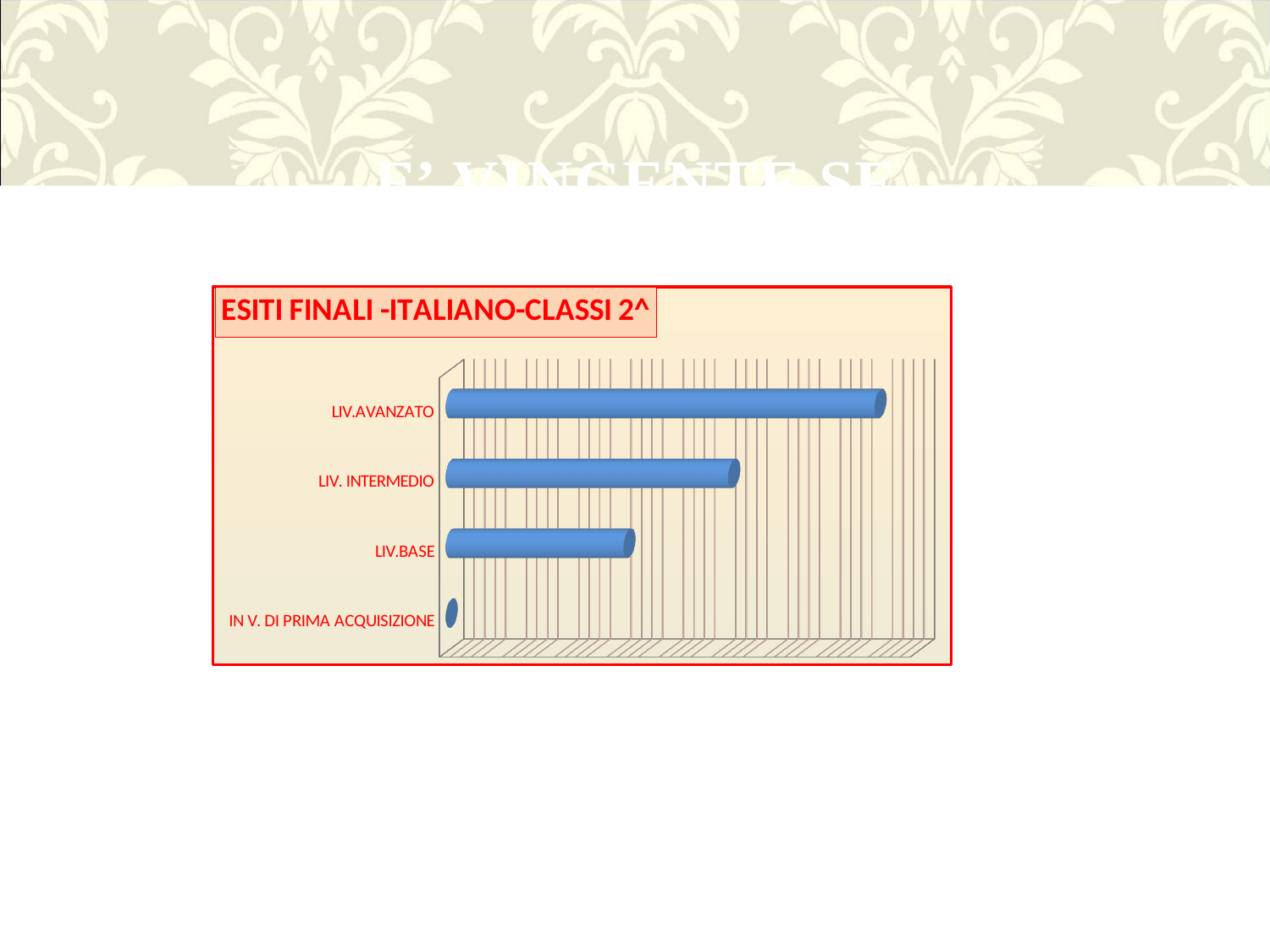
Which category has the lowest value? IN V. DI PRIMA ACQUISIZIONE Which is larger, the value for LIV.AVANZATO or the value for LIV. INTERMEDIO? LIV.AVANZATO What colour are the bars in the chart? blue Which is larger, the value for LIV. INTERMEDIO or the value for LIV.BASE? LIV. INTERMEDIO What kind of chart is shown on the slide? bar chart Which category has the second-highest value? LIV. INTERMEDIO How many categories are plotted in the chart? 4 Which is larger, the value for LIV.BASE or the value for IN V. DI PRIMA ACQUISIZIONE? LIV.BASE What is the title of the chart? ESITI FINALI -ITALIANO-CLASSI 2^ Which category has the highest value? LIV.AVANZATO